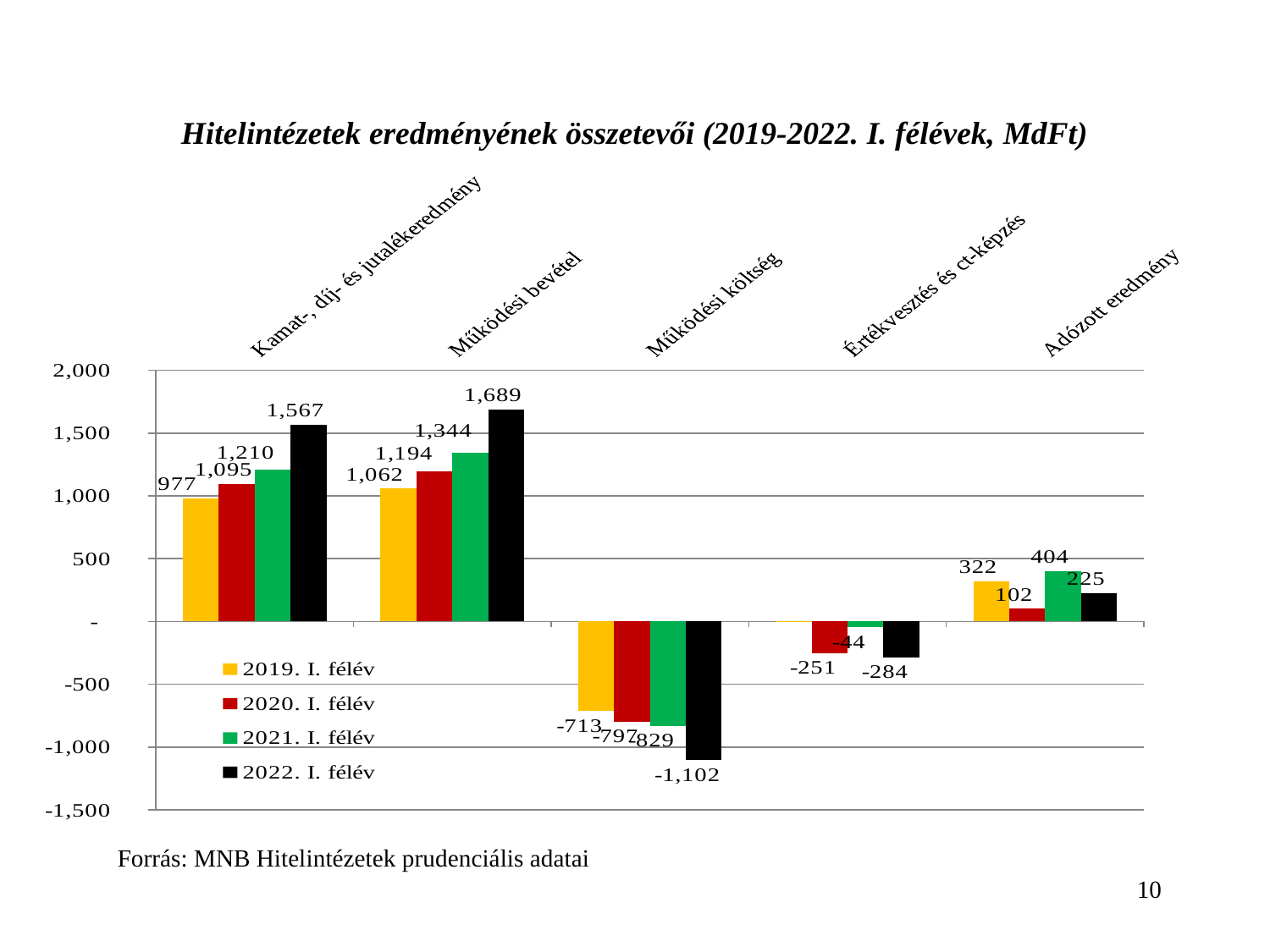
How many categories are shown on the x axis? 5 What is the value for 2021. I. félév in the Adózott eredmény category? 404 How many series does the legend list? 4 What is the value for 2020. I. félév in the Értékvesztés és ct-képzés category? -251 Do the values in the Kamat-, díj- és jutalékeredmény category rise or fall from 2019. I. félév to 2022. I. félév? Rise What kind of chart is shown on the slide? Bar chart What is the value for 2022. I. félév in the Működési bevétel category? 1,689 Which is larger in the Adózott eredmény category: the 2019. I. félév value or the 2022. I. félév value? 2019. I. félév What is the value for 2019. I. félév in the Kamat-, díj- és jutalékeredmény category? 977 What is the difference between the 2022. I. félév and 2019. I. félév values in the Működési bevétel category? 627 Which series has the highest value in the Adózott eredmény category? 2021. I. félév Which series has the lowest value in the Működési költség category? 2022. I. félév